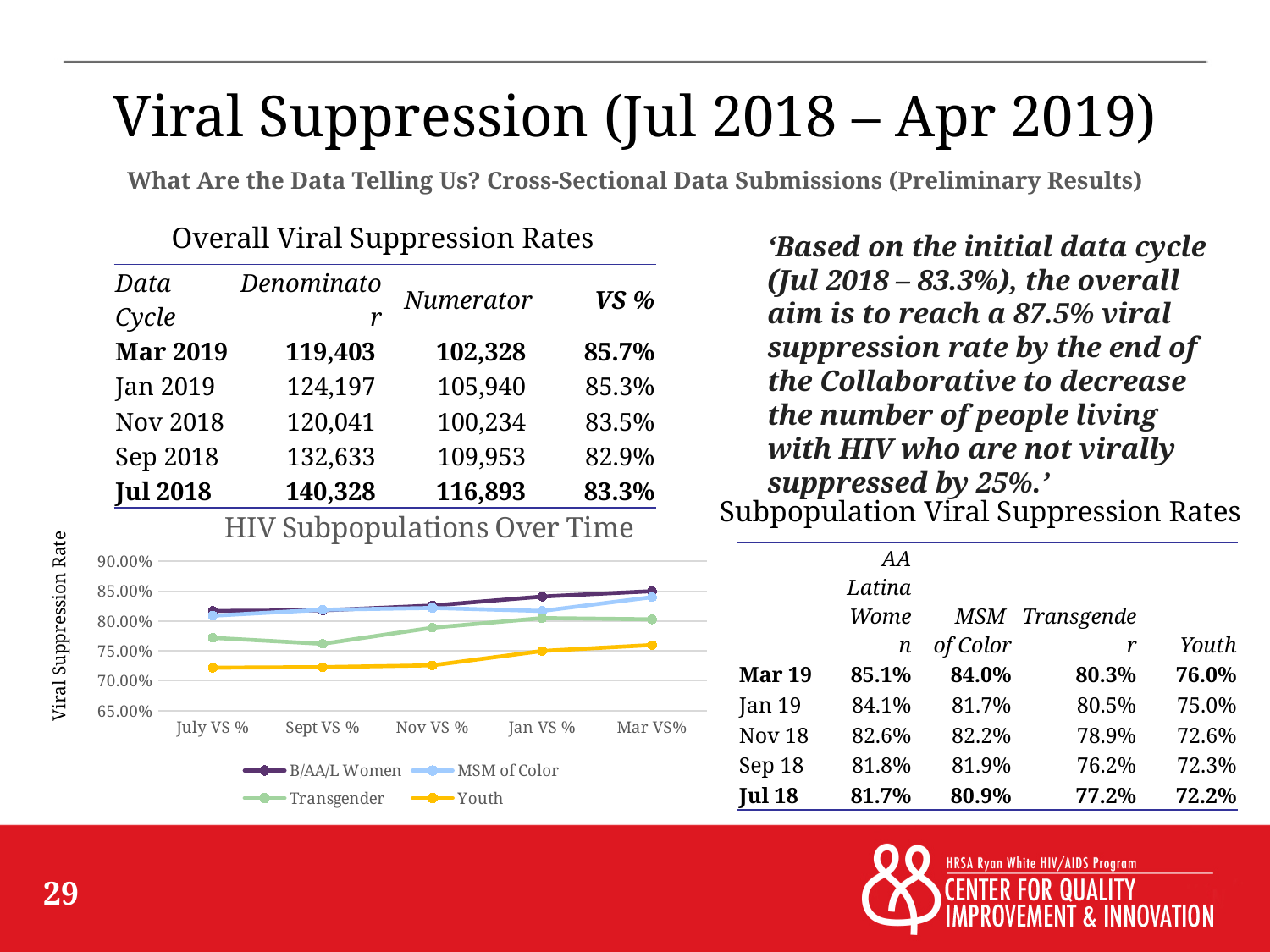
In the "HIV Subpopulations Over Time" chart, which subpopulation has the highest viral suppression rate at Mar VS%? B/AA/L Women How many data cycles are shown along the x axis of the "HIV Subpopulations Over Time" chart? 5 In the "HIV Subpopulations Over Time" chart, which subpopulation has the lowest viral suppression rate across all data cycles? Youth What is the label of the y axis on the "HIV Subpopulations Over Time" chart? Viral Suppression Rate In the "HIV Subpopulations Over Time" chart, is the MSM of Color value at Jan VS % greater or less than 80.00%? greater In the "HIV Subpopulations Over Time" chart, is the Youth value at July VS % greater or less than 75.00%? less In the "HIV Subpopulations Over Time" chart, which is higher at Nov VS %: Transgender or Youth? Transgender In the "HIV Subpopulations Over Time" chart, does the Youth line rise or fall from July VS % to Mar VS%? rise How many series does the legend of the "HIV Subpopulations Over Time" chart list? 4 What kind of chart is "HIV Subpopulations Over Time"? line chart In the "HIV Subpopulations Over Time" chart, is the Transgender value at Sept VS % greater or less than 75.00%? greater In the "HIV Subpopulations Over Time" chart, what colour is the Youth line? yellow